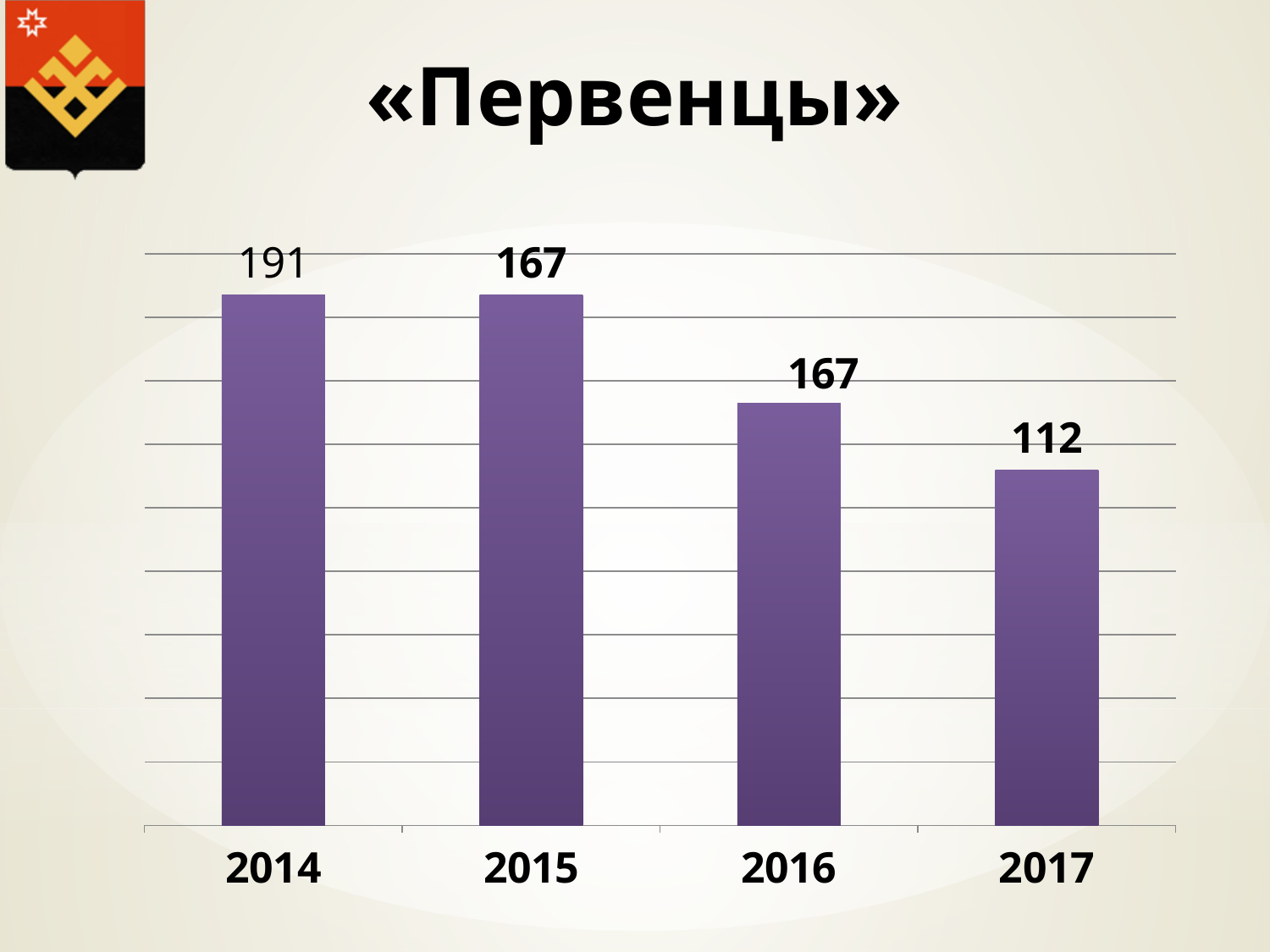
What is the value for 2016? 167 Which is larger, the value for 2016 or the value for 2017? 2016 What is the difference between the values for 2014 and 2017? 79 What is the value for 2014? 191 Which is larger, the value for 2014 or the value for 2017? 2014 What is the value for 2015? 167 What is the value for 2017? 112 How many years are shown on the chart? 4 Which year has the lowest value? 2017 Do the values rise or fall from 2014 to 2017? fall What kind of chart is shown on the slide? bar chart What is the difference between the values for 2015 and 2017? 55